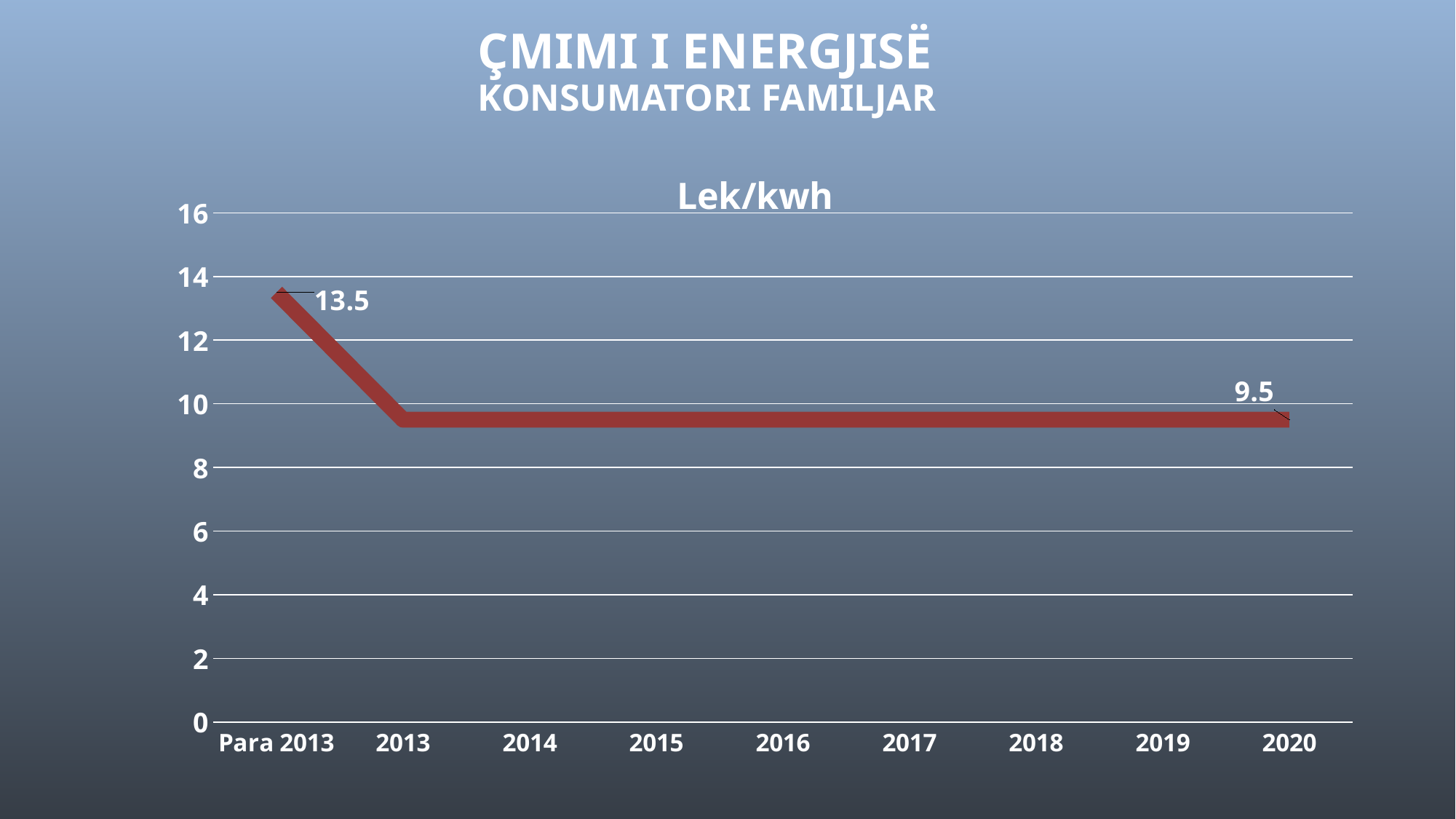
What kind of chart is shown on the slide? line chart Which is larger, the value for Para 2013 or the value for 2020? Para 2013 What is the value for Para 2013? 13.5 Which category has the highest value? Para 2013 Is the value for 2016 greater or less than 12? less What is the value for 2020? 9.5 What is the difference between the value for Para 2013 and the value for 2020? 4 Is the value for 2014 greater or less than 8? greater Is the value for Para 2013 greater or less than 12? greater Do the values rise or fall from Para 2013 to 2020? fall What is the title of the chart? Lek/kwh How many categories are shown on the x axis? 9